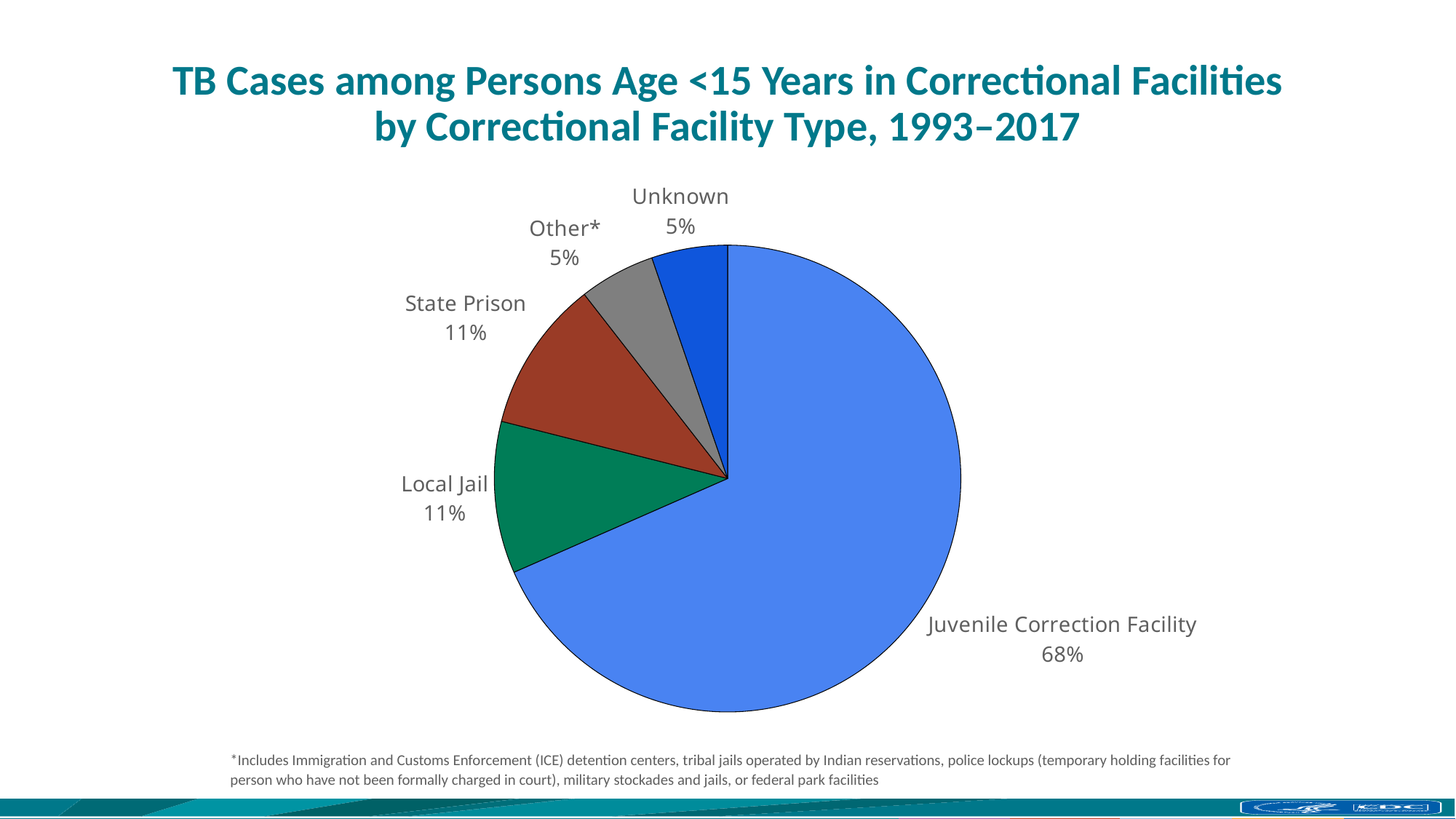
What percentage of cases is attributed to State Prison? 11% How many facility type categories are shown in the pie chart? 5 What percentage of cases has an Unknown facility type? 5% What colour is the Local Jail slice? Green What percentage of cases is attributed to Local Jail? 11% Which is larger, the share for Local Jail or the share for Unknown? Local Jail What is the combined share of the State Prison and Local Jail slices? 22% What percentage of cases falls in the Other* category? 5% What is the difference in percentage points between the Juvenile Correction Facility share and the State Prison share? 57 What share of TB cases among persons age <15 years in correctional facilities occurred in a Juvenile Correction Facility? 68% What type of chart is shown on the slide? Pie chart Which facility type accounts for the largest share of cases? Juvenile Correction Facility